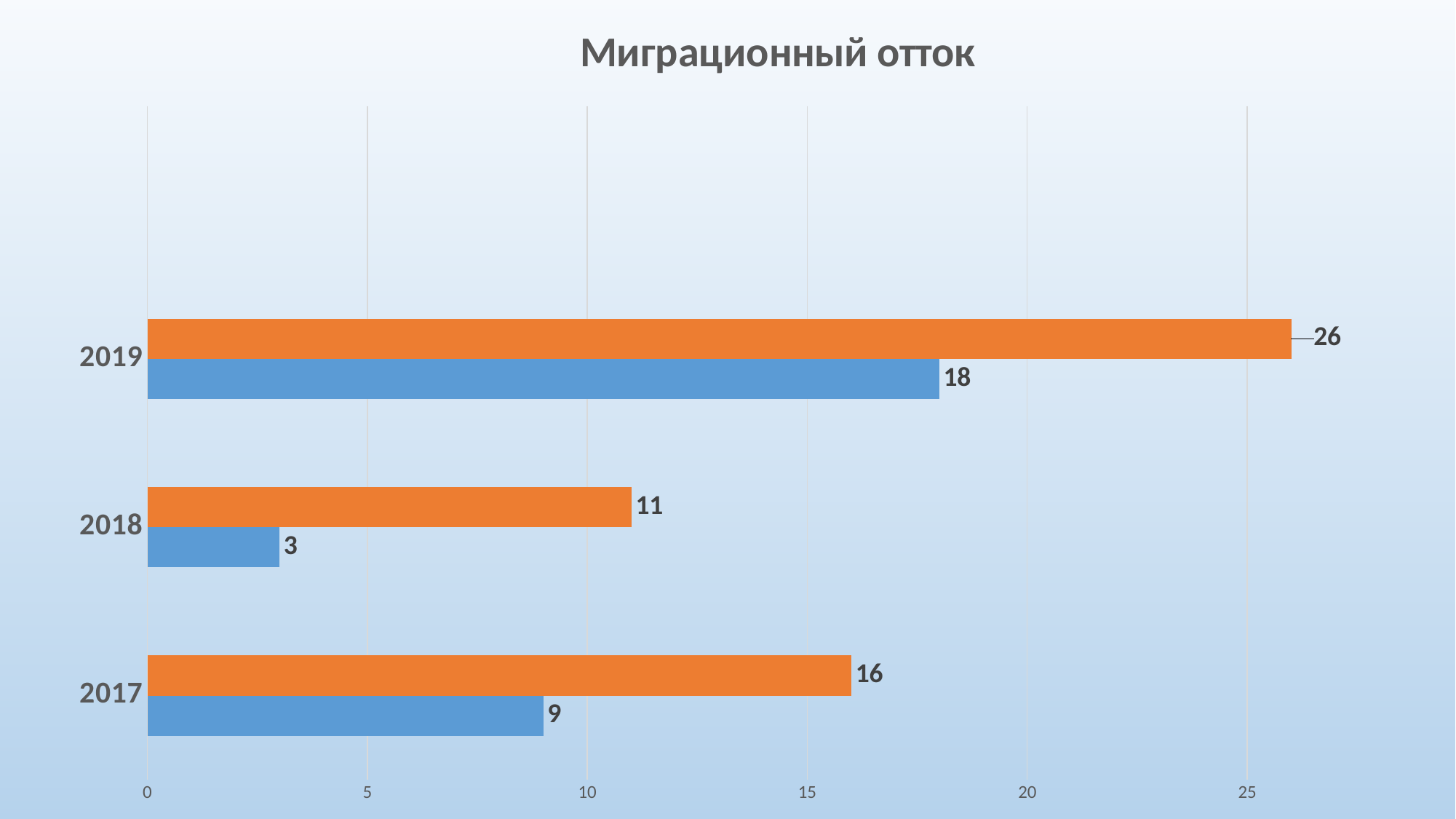
What is the value of the blue bar for 2019? 18 What type of chart is shown on the slide? bar chart What is the value of the blue bar for 2018? 3 What is the title of the chart? Миграционный отток What is the difference between the orange and blue bars for 2017? 7 Which year has the highest value for the orange bars? 2019 Which year has the lowest value for the blue bars? 2018 How many categories (years) are shown on the chart? 3 How many bars are plotted for each year? 2 What is the value of the orange bar for 2017? 16 Which is larger: the orange bar for 2018 or the blue bar for 2017? the orange bar for 2018 What is the value of the orange bar for 2019? 26